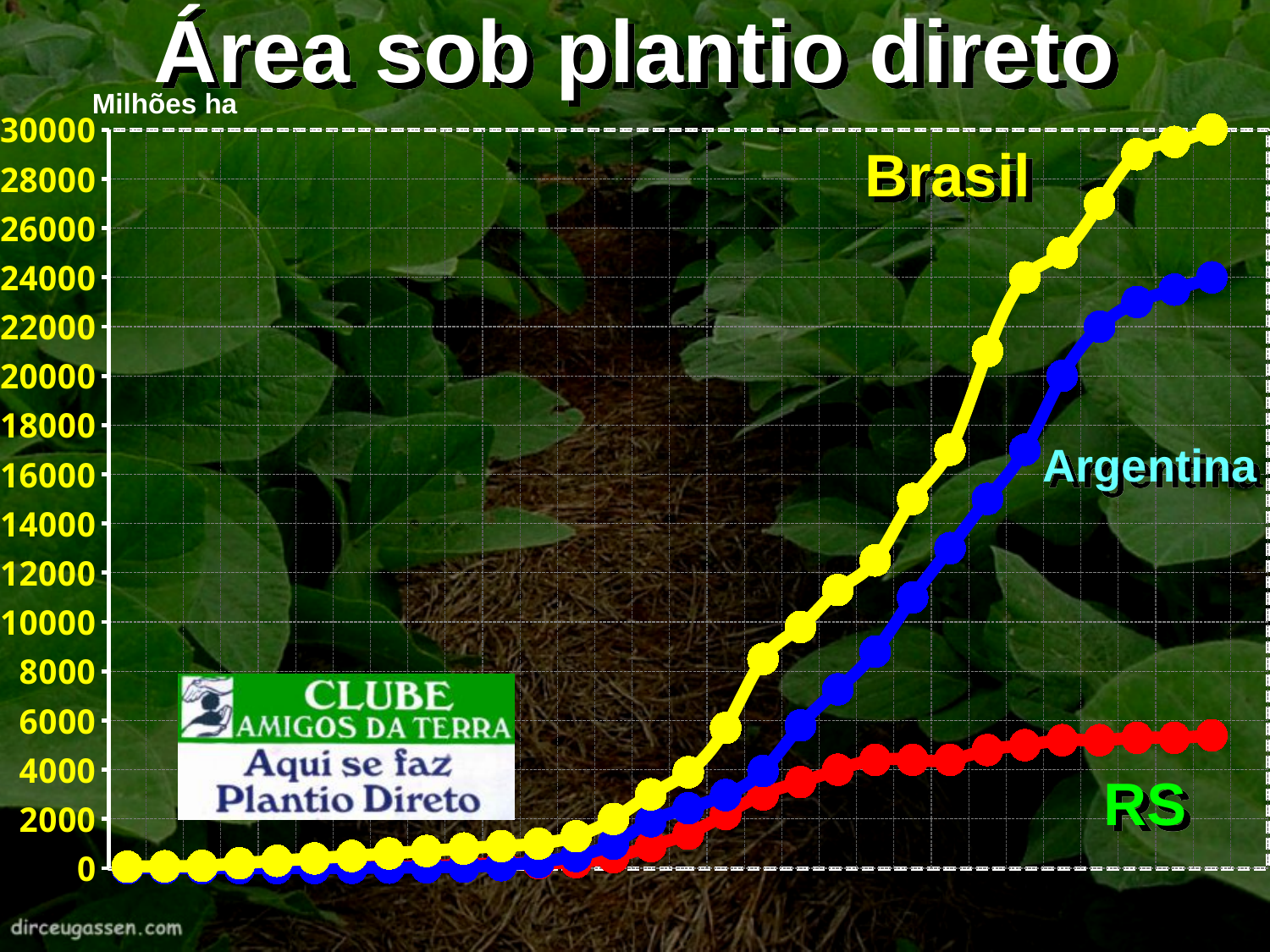
What is the highest value shown on the y axis? 30000 What kind of chart is shown on the slide? line chart Which series has the lowest value at the right end of the chart? RS What is the title of the chart? Área sob plantio direto Is the final value for Argentina greater or less than 20000? greater Which series reaches the highest value at the right end of the chart? Brasil Do the values for Brasil rise or fall along the x axis? rise How many series are plotted on the chart? 3 Is the final value for RS greater or less than 8000? less Which series ends higher, Argentina or RS? Argentina What unit is shown on the y axis label? Milhões ha Is the final value for Brasil greater or less than 26000? greater